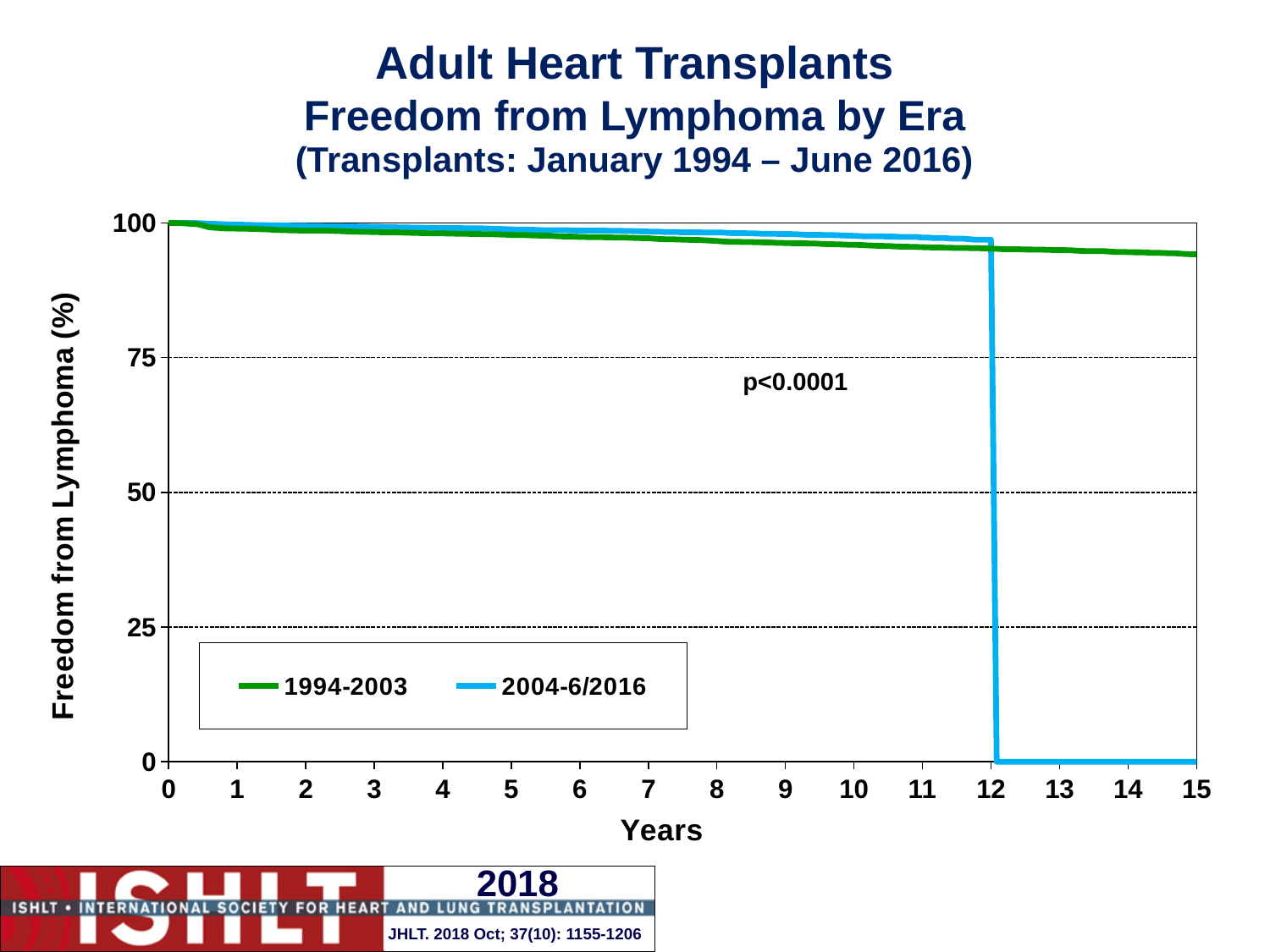
What is the value of the 1994-2003 series at 0 years? 100 What kind of chart is shown on the slide? line chart Is the value for the 2004-6/2016 series at 14 years greater or less than 25? less Does the 1994-2003 line rise or fall as years increase? fall At 13 years, which series has the higher value, 1994-2003 or 2004-6/2016? 1994-2003 What is the label of the y axis? Freedom from Lymphoma (%) Is the value for the 1994-2003 series at 10 years greater or less than 50? greater What is the value of the 2004-6/2016 series at 14 years? 0 What are the two eras listed in the legend? 1994-2003 and 2004-6/2016 How many series does the legend list? 2 Is the value for the 1994-2003 series at 15 years greater or less than 75? greater What p-value is printed on the chart? p<0.0001